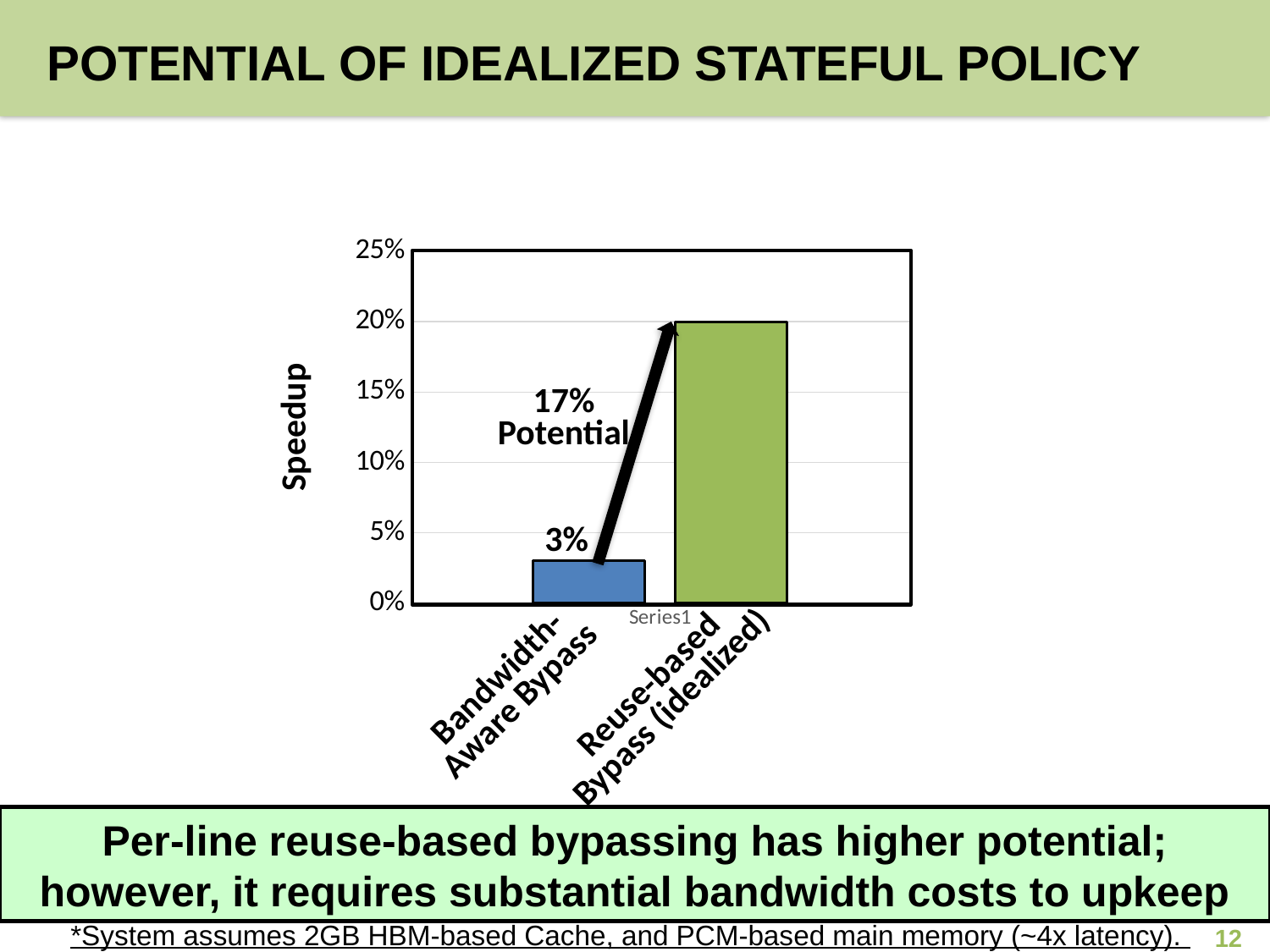
What potential improvement does the arrow annotation in the chart indicate? 17% Potential What type of chart is shown on the slide? bar chart Which bar has the lowest speedup? Bandwidth-Aware Bypass What is the label on the vertical axis of the chart? Speedup What is the speedup value shown for Bandwidth-Aware Bypass? 3% Is the speedup for Reuse-based Bypass (idealized) greater or less than 15%? greater Is the speedup for Bandwidth-Aware Bypass greater or less than 5%? less Which bar has the highest speedup? Reuse-based Bypass (idealized) How many bars are plotted in the chart? 2 What is the maximum value shown on the vertical axis? 25% Which has a larger speedup, Bandwidth-Aware Bypass or Reuse-based Bypass (idealized)? Reuse-based Bypass (idealized)